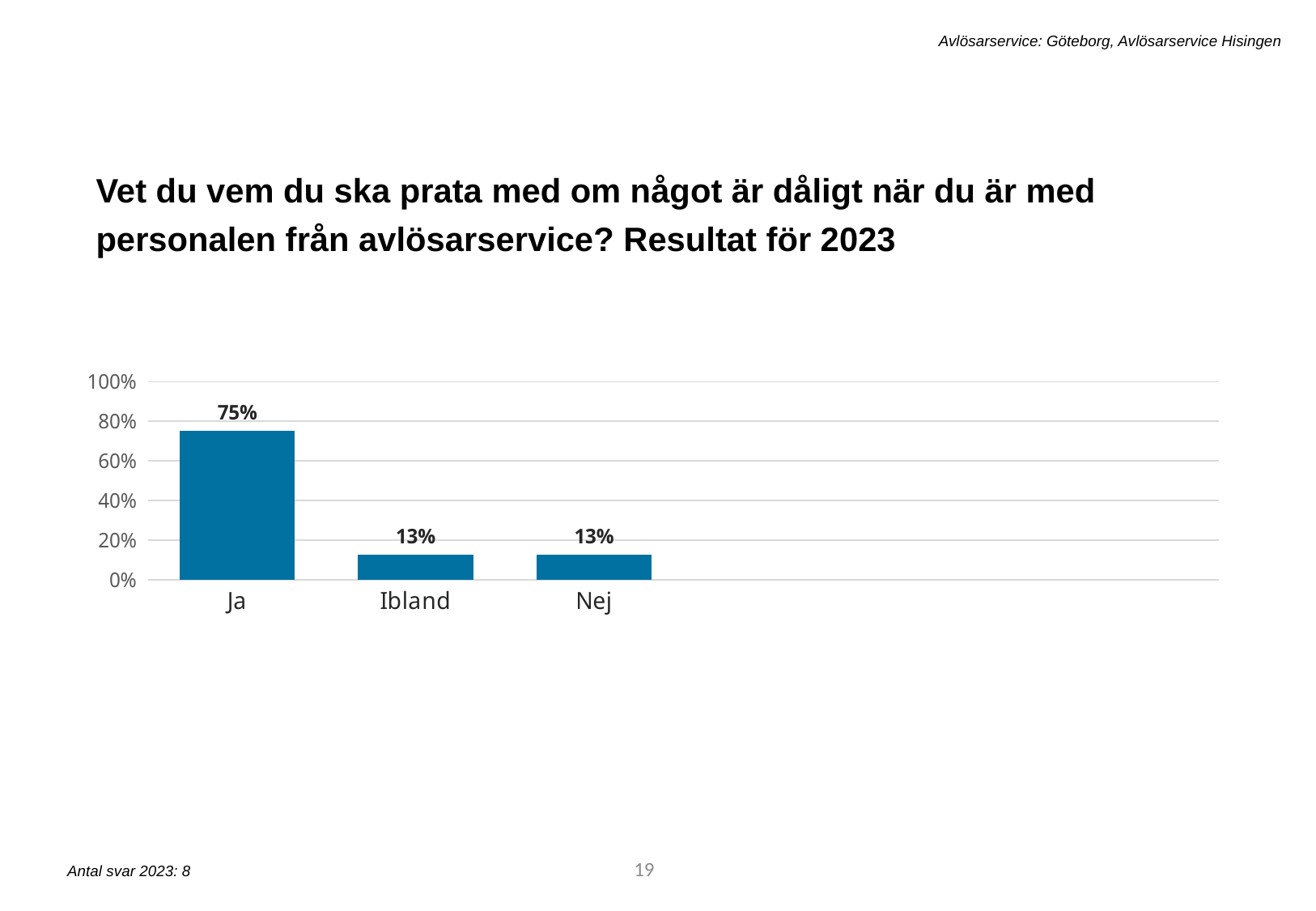
What is the difference between the values for Ja and Ibland? 62% What is the value for Ibland? 13% What is the value for Ja? 75% How many responses (Antal svar) were recorded for 2023 according to the slide? 8 What kind of chart is shown on the slide? bar chart Which is larger, the value for Ja or the value for Nej? Ja Is the value for Nej greater or less than 20%? less Which category has the highest value? Ja What is the value for Nej? 13% What is the highest value shown on the y axis? 100% How many categories are shown on the x axis? 3 Is the value for Ja greater or less than 60%? greater